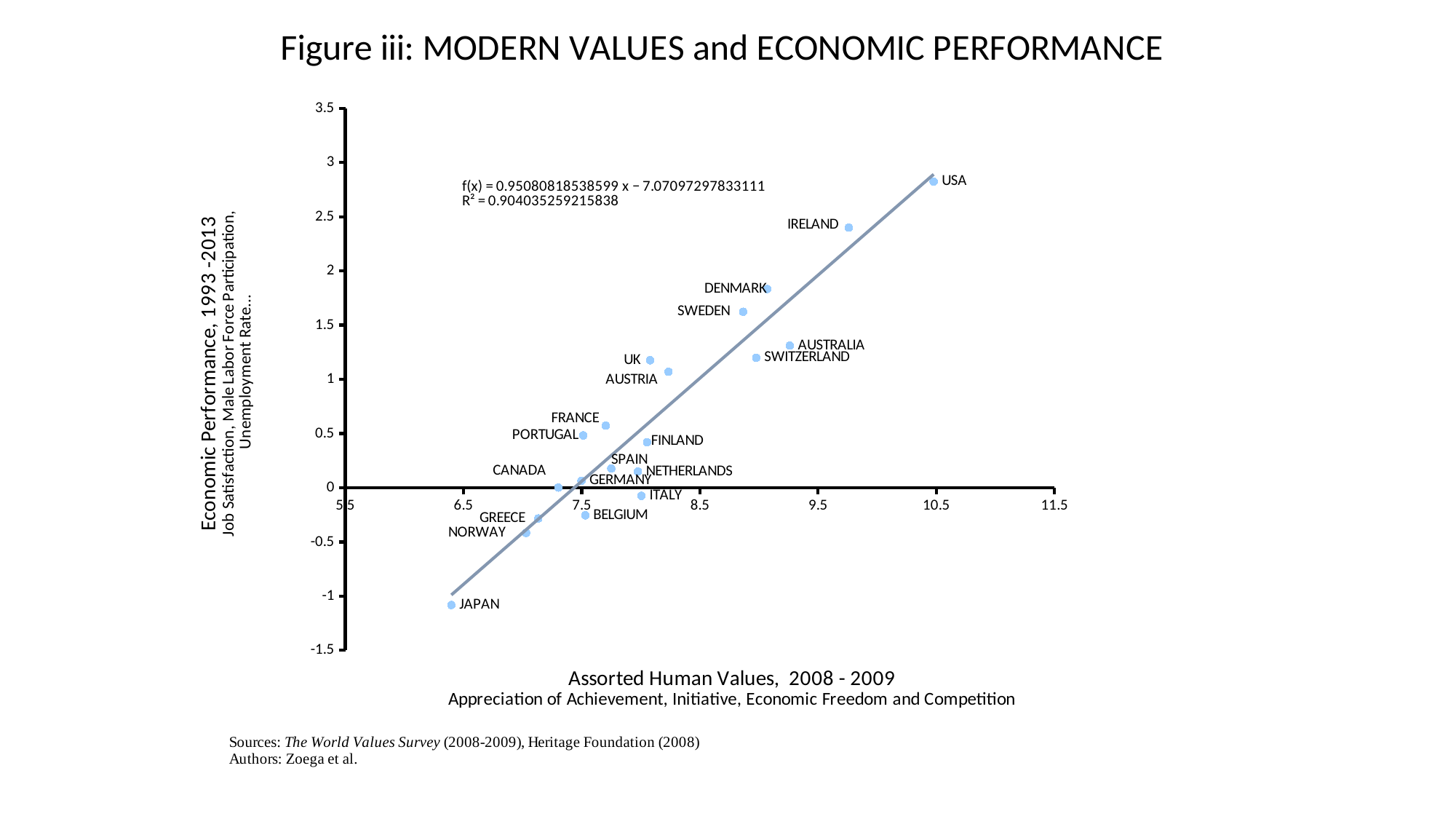
Is the economic performance value for USA greater or less than 2.5? greater Which country has the highest economic performance value on the chart? USA What R² value is printed on the chart for the trend line? 0.904035259215838 Is the economic performance value for JAPAN greater or less than -0.5? less Do the economic performance values generally rise or fall as the human values score increases along the x axis? rise What kind of chart is shown on the slide? scatter chart Which country has the lowest economic performance value on the chart? JAPAN Which has a higher economic performance value, DENMARK or SWEDEN? DENMARK Which has a higher economic performance value, IRELAND or AUSTRALIA? IRELAND Is the economic performance value for IRELAND greater or less than 2? greater How many countries are plotted on the chart? 20